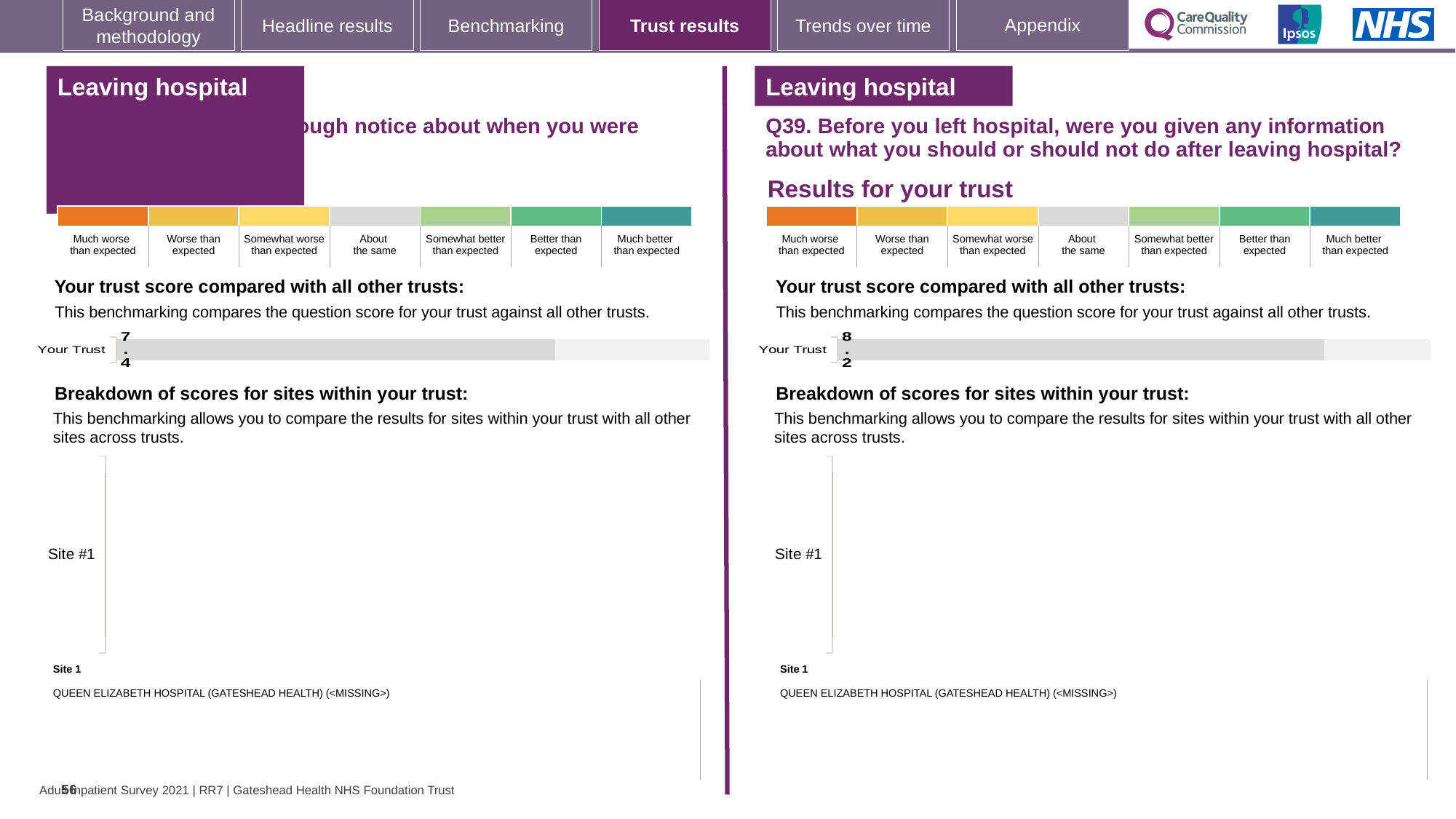
On the right panel (Q39) 'Your trust score compared with all other trusts' chart, what is the score shown for Your Trust? 8.2 What is the difference between the Your Trust score on the right panel (Q39) and the Your Trust score on the left panel? 0.8 On the right panel (Q39), how many rating categories does the colour scale above the trust score show? 7 On the left panel's 'Breakdown of scores for sites within your trust' chart, how many sites are listed? 1 What kind of chart is used to show the Your Trust score on each panel? Bar chart On the right panel (Q39) colour scale, what colour is the 'Much worse than expected' category? Orange On the left panel's 'Your trust score compared with all other trusts' chart, what is the score shown for Your Trust? 7.4 Which panel shows the higher Your Trust score, the left panel or the right panel (Q39)? The right panel (Q39) On the right panel (Q39) 'Your Trust' chart, how many bars are plotted? 1